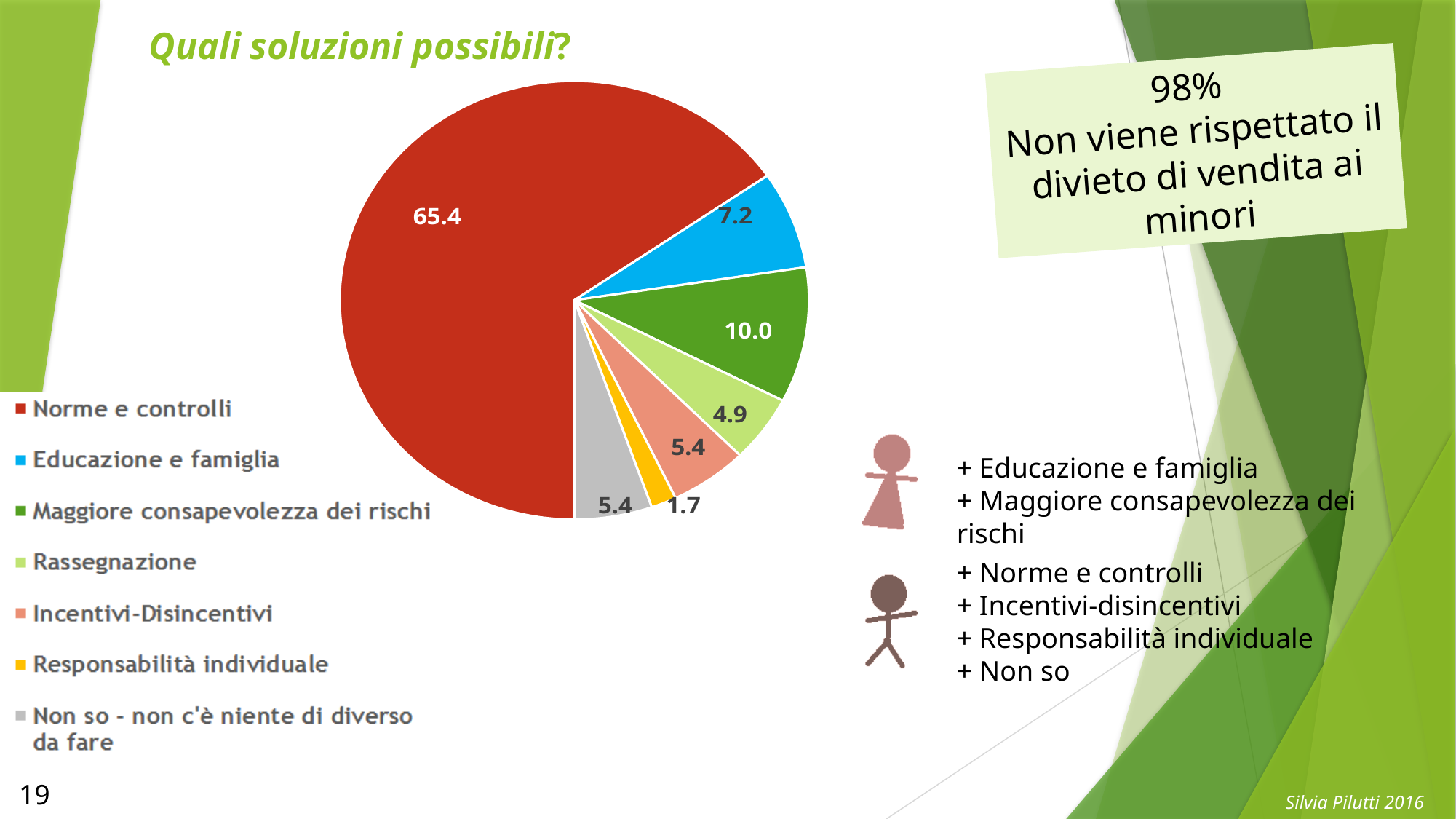
What is the value for Responsabilità individuale? 1.7 What is the value for Norme e controlli? 65.4 What is the difference between the values for Maggiore consapevolezza dei rischi and Educazione e famiglia? 2.8 What colour is the slice for Educazione e famiglia? blue Which is larger, the value for Rassegnazione or the value for Incentivi-Disincentivi? Incentivi-Disincentivi Which category has the largest slice of the pie? Norme e controlli What is the title of the slide containing the pie chart? Quali soluzioni possibili? How many categories does the legend of the pie chart list? 7 Which category has the smallest slice of the pie? Responsabilità individuale What kind of chart is shown on the slide? pie chart What is the value for Educazione e famiglia? 7.2 What is the value for Maggiore consapevolezza dei rischi? 10.0